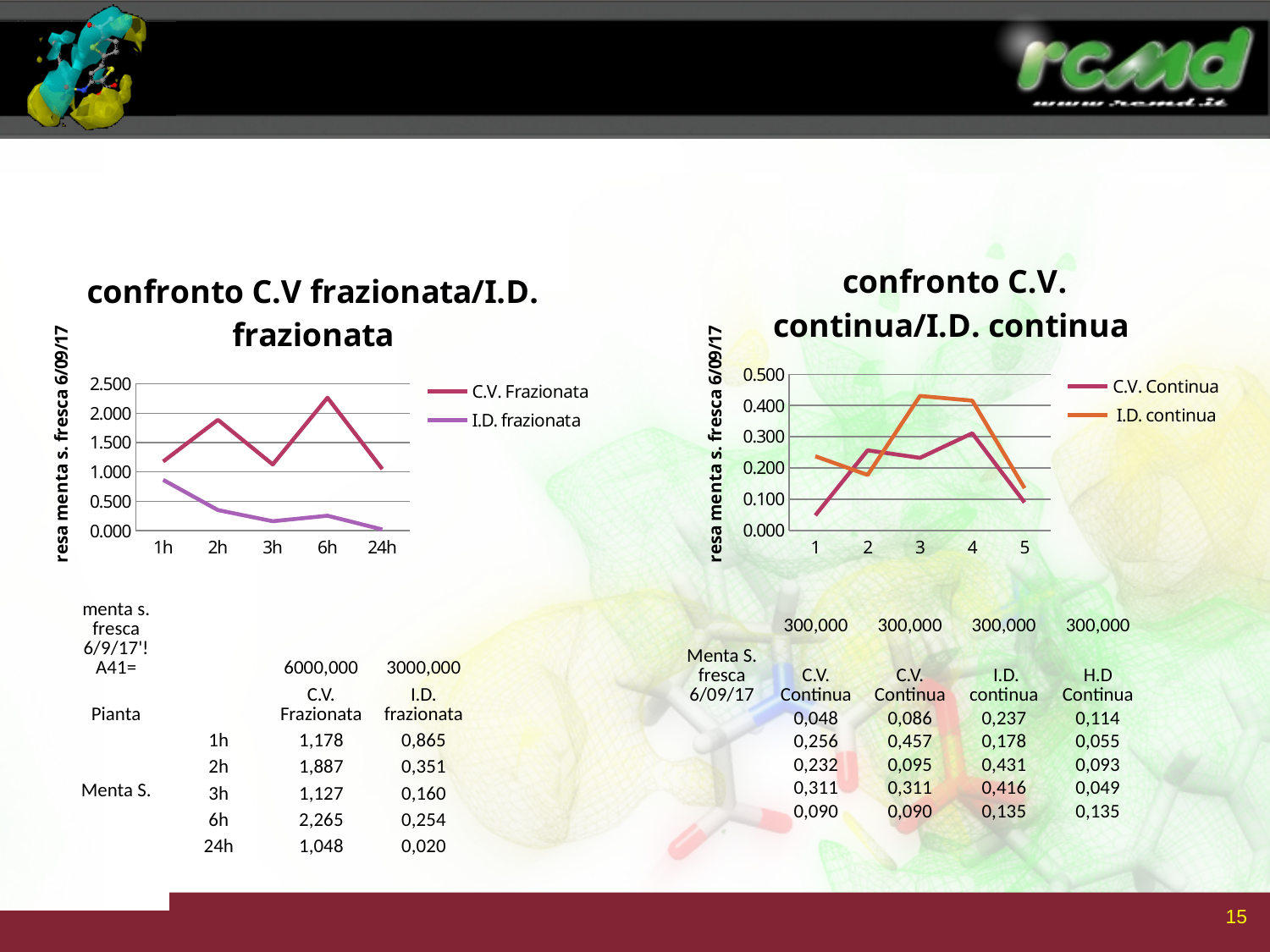
How many time points are shown on the x axis of the left chart "confronto C.V frazionata/I.D. frazionata"? 5 In the right chart "confronto C.V. continua/I.D. continua", which series has the larger value at point 1, C.V. Continua or I.D. continua? I.D. continua In the left chart "confronto C.V frazionata/I.D. frazionata", at which time point is I.D. frazionata lowest? 24h In the right chart "confronto C.V. continua/I.D. continua", is the value of I.D. continua at point 3 greater or less than 0.400? greater In the right chart "confronto C.V. continua/I.D. continua", at which x-axis point is C.V. Continua highest? 4 In the left chart "confronto C.V frazionata/I.D. frazionata", is the value of I.D. frazionata at 1h greater or less than 0.500? greater How many series does the legend of the right chart "confronto C.V. continua/I.D. continua" list? 2 In the right chart "confronto C.V. continua/I.D. continua", at which x-axis point is C.V. Continua lowest? 1 What kind of chart is the left chart titled "confronto C.V frazionata/I.D. frazionata"? line chart In the left chart "confronto C.V frazionata/I.D. frazionata", does I.D. frazionata generally rise or fall from 1h to 24h? fall In the left chart "confronto C.V frazionata/I.D. frazionata", at which time point does C.V. Frazionata reach its highest value? 6h In the left chart "confronto C.V frazionata/I.D. frazionata", is the value of C.V. Frazionata at 6h greater or less than 2.000? greater